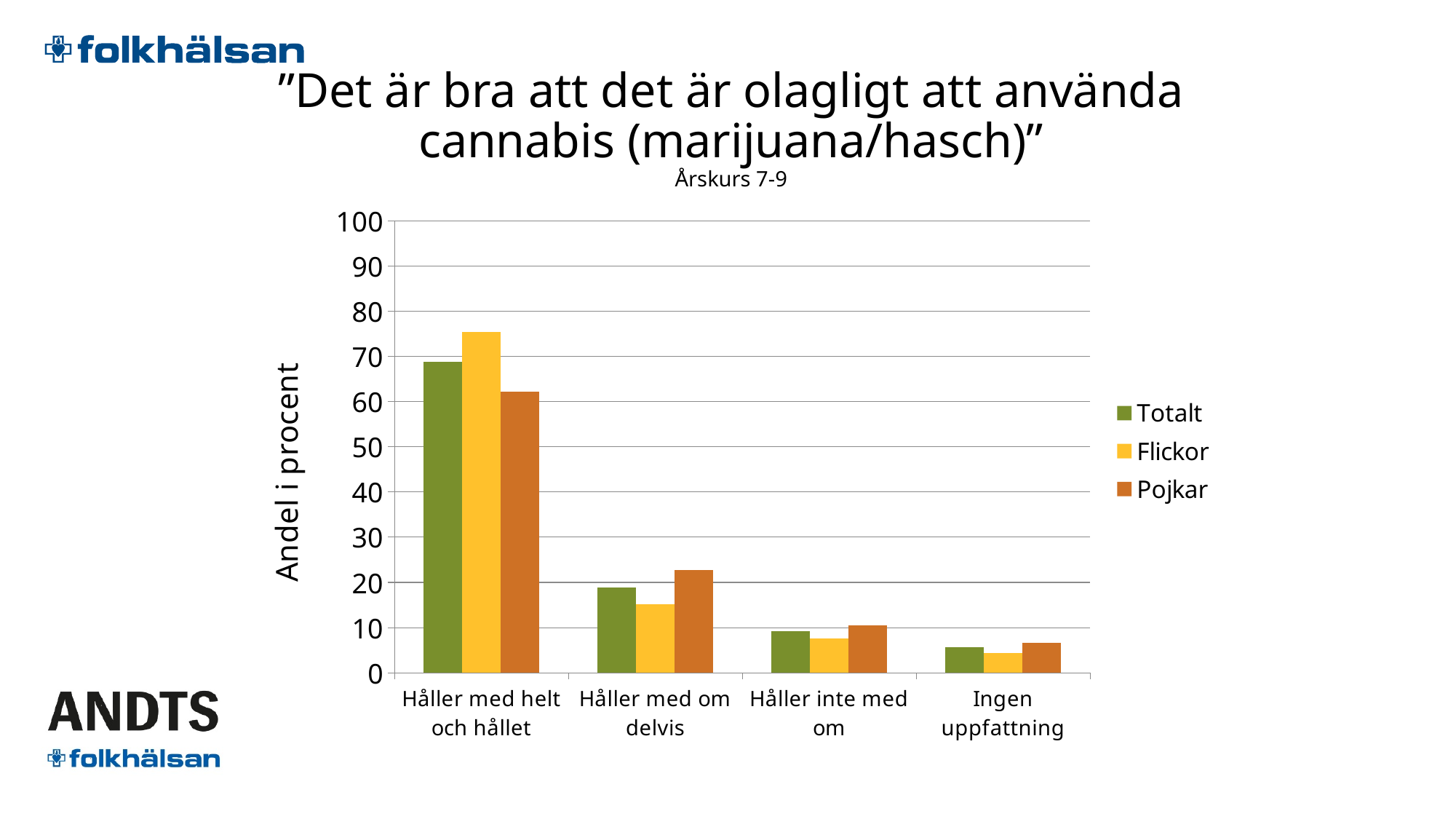
Is the value for Flickor in Håller med om delvis greater or less than 20? less Which is larger in the category Håller inte med om: Flickor or Pojkar? Pojkar What kind of chart is shown on the slide? bar chart Which series has the lowest bar in the category Håller med om delvis? Flickor What is the label of the y axis? Andel i procent Which category has the highest value for Flickor? Håller med helt och hållet How many categories are shown on the x axis? 4 Is the value for Pojkar in Håller med om delvis greater or less than 20? greater How many series does the legend list? 3 Which category has the lowest value for Pojkar? Ingen uppfattning Which series has the highest bar in the category Håller med helt och hållet? Flickor Is the value for Flickor in Håller med helt och hållet greater or less than 70? greater